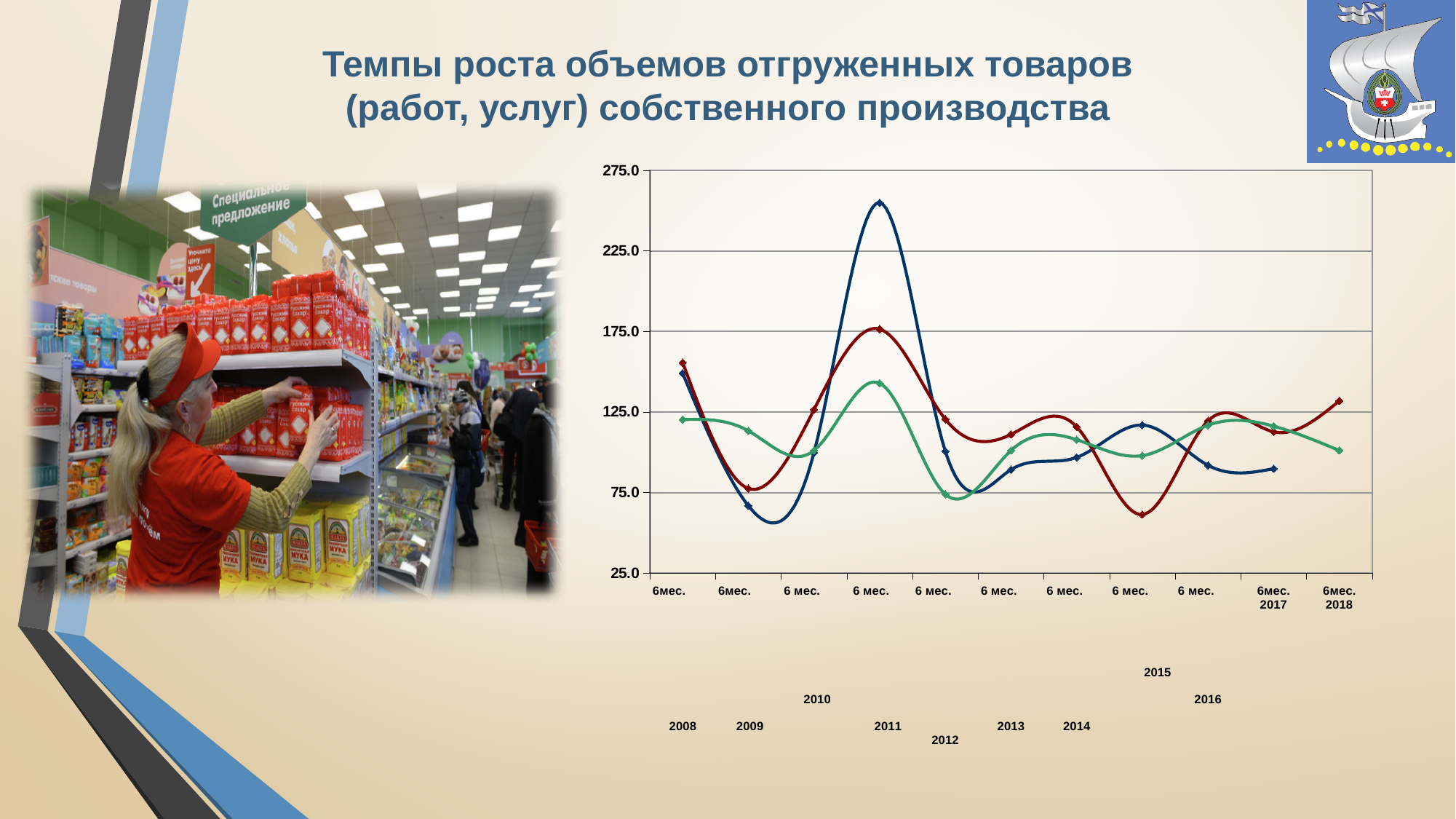
Is the value of the red line for 6 мес. 2015 greater or less than 75.0? less What is the highest tick value shown on the vertical axis of the chart? 275.0 How many lines are plotted on the chart? 3 Does the dark blue line rise or fall from 6 мес. 2011 to 6 мес. 2012? fall In which year does the dark blue line reach its highest value? 2011 What kind of chart is shown on the slide? line chart In which year does the red line reach its lowest value? 2015 Is the value of the green line for 6 мес. 2011 greater or less than 125.0? greater At 6 мес. 2011, which line has the larger value, the dark blue line or the red line? dark blue line At 6 мес. 2018, which line has the larger value, the red line or the green line? red line Is the value of the dark blue line for 6 мес. 2011 greater or less than 225.0? greater